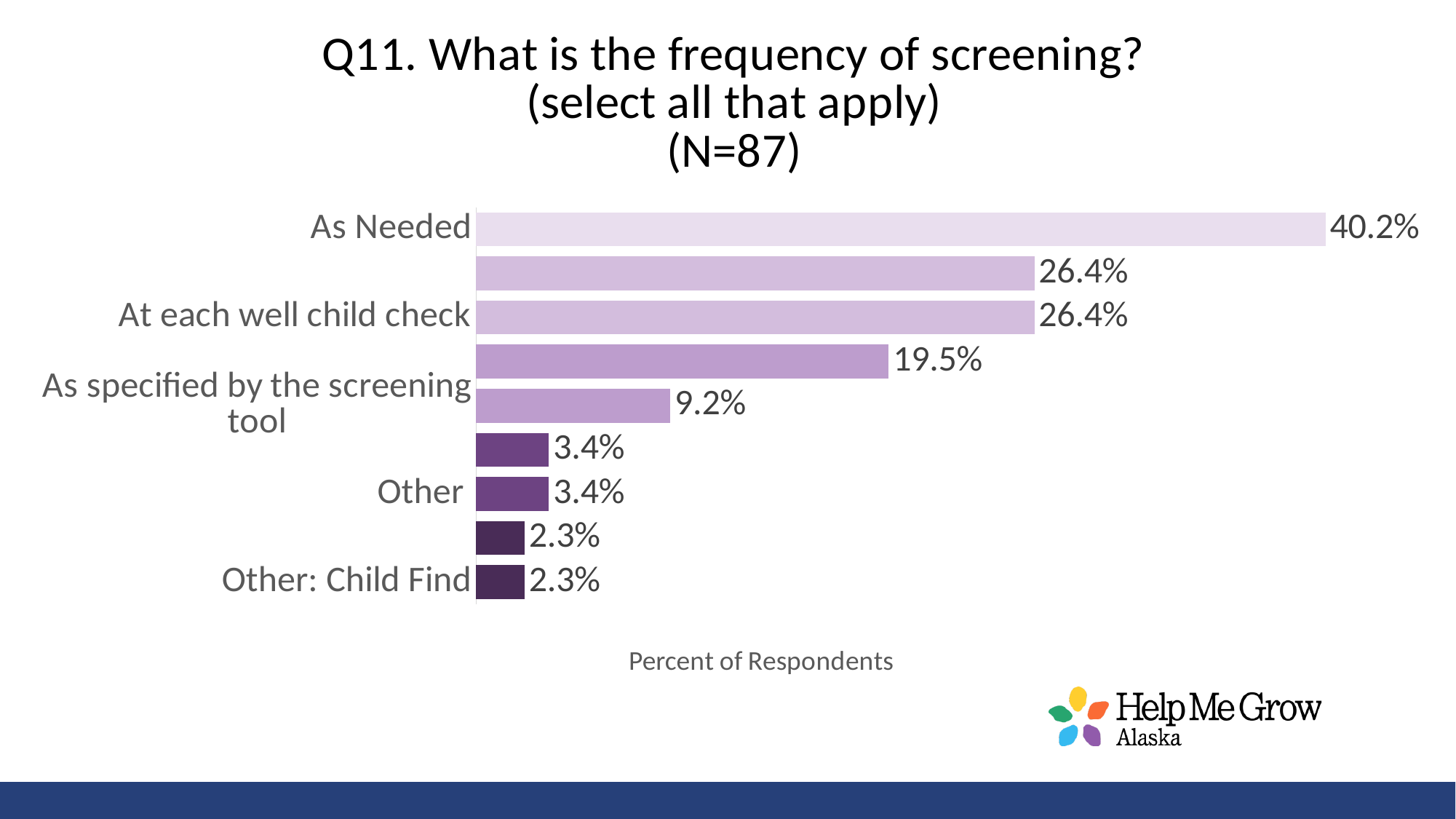
Which category has the highest value? As Needed How many bars are plotted on the chart? 9 What is the value for Other: Child Find? 2.3% What is the value for Other? 3.4% What is the title of the horizontal axis? Percent of Respondents What is the difference between the values for As Needed and At each well child check? 13.8% What is the lowest value shown on the chart? 2.3% What is the value for At each well child check? 26.4% What is the value for As specified by the screening tool? 9.2% What kind of chart is shown on the slide? Bar chart What is the value for As Needed? 40.2% Which is larger, the value for As specified by the screening tool or the value for Other? As specified by the screening tool